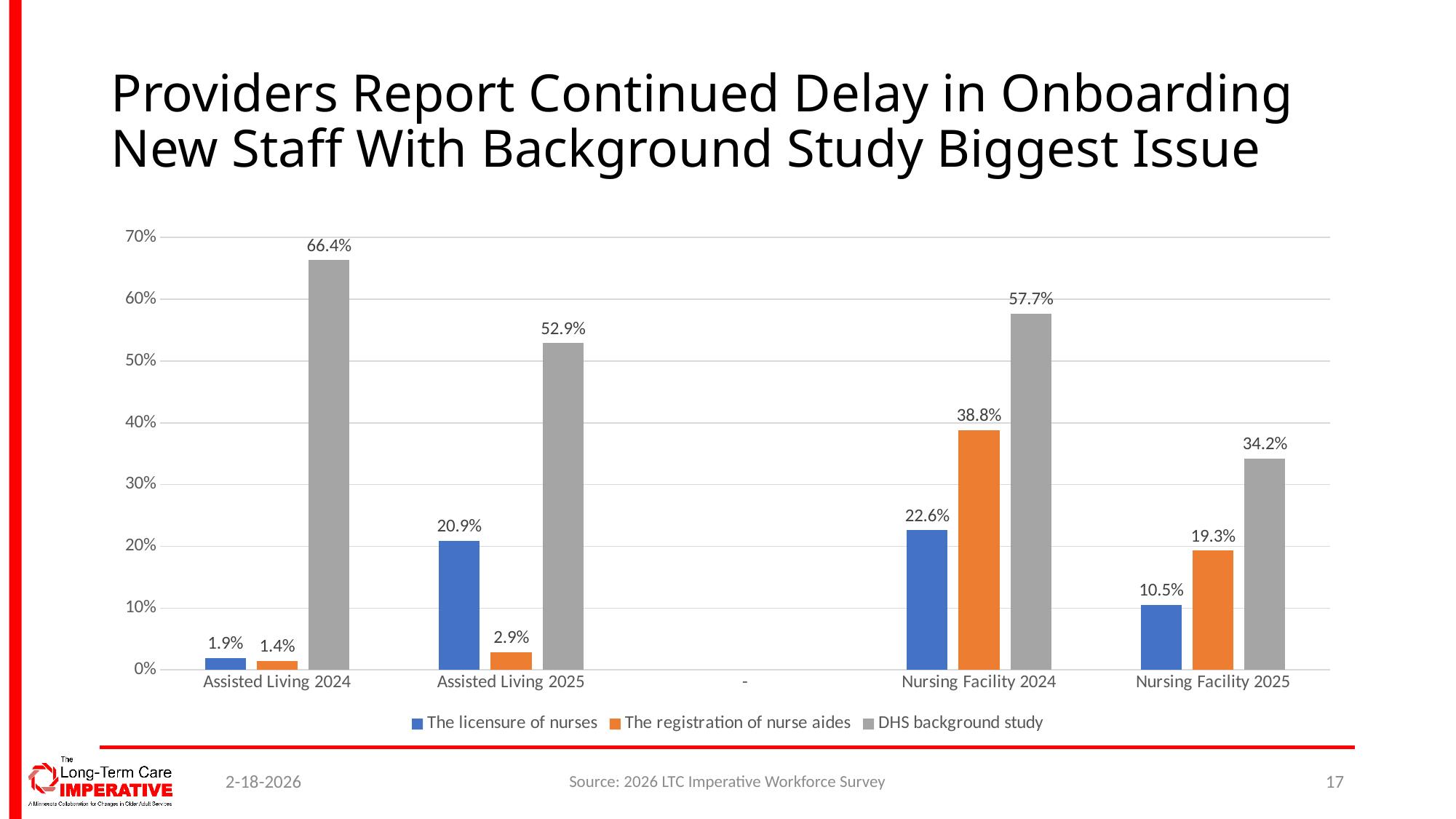
Which category has the highest value for DHS background study? Assisted Living 2024 What is the value for DHS background study for Assisted Living 2024? 66.4% What kind of chart is shown on the slide? Bar chart What is the value for The licensure of nurses for Assisted Living 2025? 20.9% Is the value for DHS background study for Nursing Facility 2024 greater or less than 50%? greater What is the difference between the DHS background study values for Assisted Living 2024 and Assisted Living 2025? 13.5% How many series does the legend list? 3 Which category has the lowest value for The registration of nurse aides? Assisted Living 2024 Which colour represents DHS background study in the legend? Gray Which is larger for Nursing Facility 2025: The licensure of nurses or The registration of nurse aides? The registration of nurse aides What is the value for The registration of nurse aides for Nursing Facility 2024? 38.8% What is the value for DHS background study for Nursing Facility 2025? 34.2%